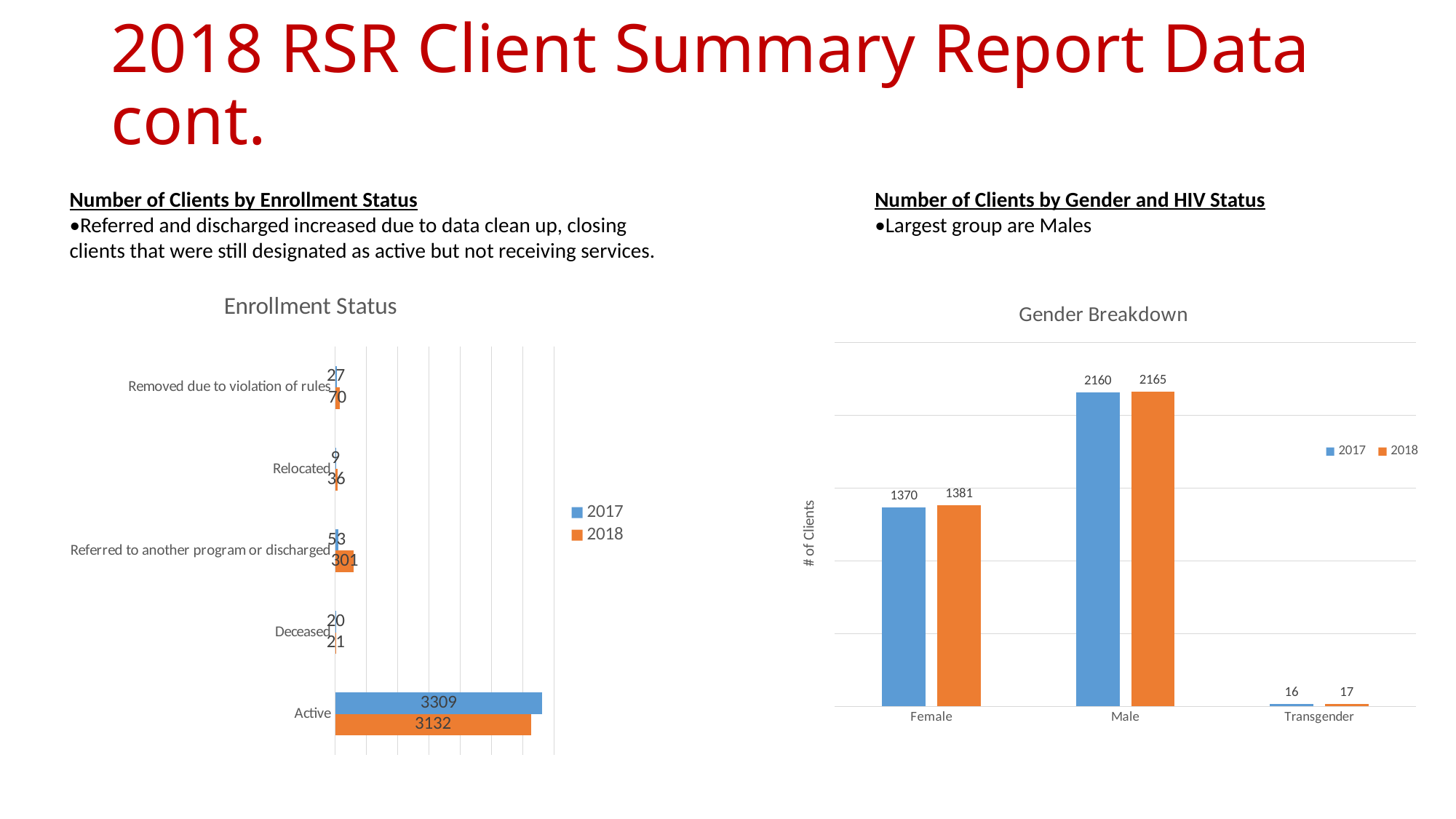
In the Enrollment Status chart, what is the value for Referred to another program or discharged in 2018? 301 In the Enrollment Status chart, what is the difference between the 2017 and 2018 values for Active? 177 In the Gender Breakdown chart, what is the value for Female in 2017? 1370 In the Gender Breakdown chart, what is the value for Male in 2018? 2165 In the Gender Breakdown chart, what is the difference between the 2018 and 2017 values for Female? 11 In the Enrollment Status chart, which is larger: the 2018 value for Relocated or the 2018 value for Removed due to violation of rules? Removed due to violation of rules In the Enrollment Status chart, what is the value for Active in 2018? 3132 What kind of chart is the Enrollment Status chart? Bar chart In the Enrollment Status chart, how many series does the legend list? 2 In the Gender Breakdown chart, which category has the lowest value in 2018? Transgender In the Gender Breakdown chart, which category has the highest value in 2017? Male In the Gender Breakdown chart, how many categories are shown on the x axis? 3